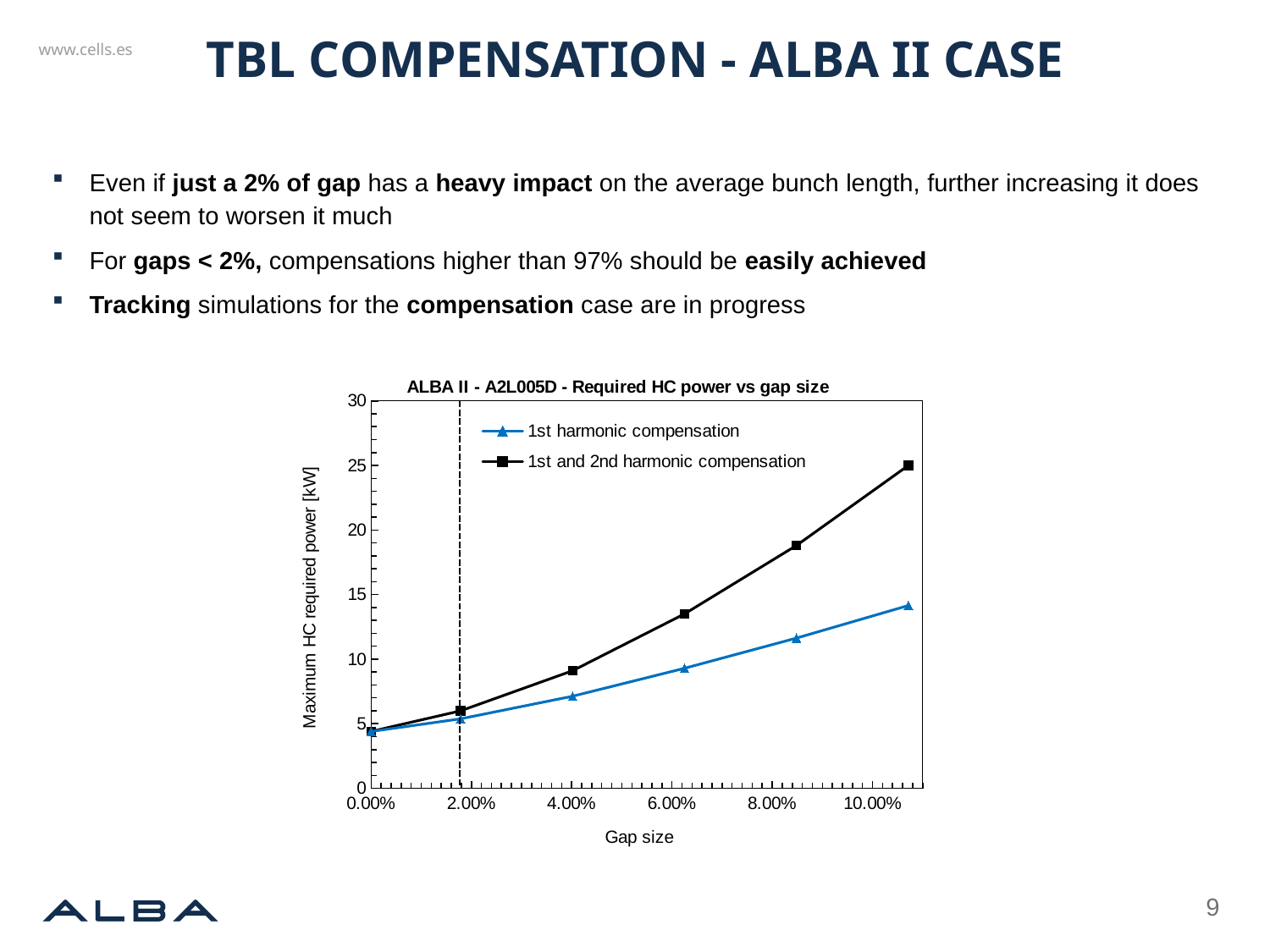
Which series is the lowest at a gap size of about 4%: '1st harmonic compensation' or '1st and 2nd harmonic compensation'? 1st harmonic compensation What is the title of the chart? ALBA II - A2L005D - Required HC power vs gap size How many series does the legend list? 2 What is the label of the y axis? Maximum HC required power [kW] Do the values of the '1st harmonic compensation' series rise or fall as gap size increases? rise At the largest gap size plotted, which series has the higher required power: '1st harmonic compensation' or '1st and 2nd harmonic compensation'? 1st and 2nd harmonic compensation Is the value of the '1st and 2nd harmonic compensation' series at a gap size of about 6.3% greater or less than 10? greater What kind of chart is shown on the slide? line chart How many data points are plotted for the '1st and 2nd harmonic compensation' series? 6 Is the value of the '1st harmonic compensation' series at the largest gap size plotted greater or less than 15? less Is the value of the '1st and 2nd harmonic compensation' series at a gap size of about 8.5% greater or less than 15? greater